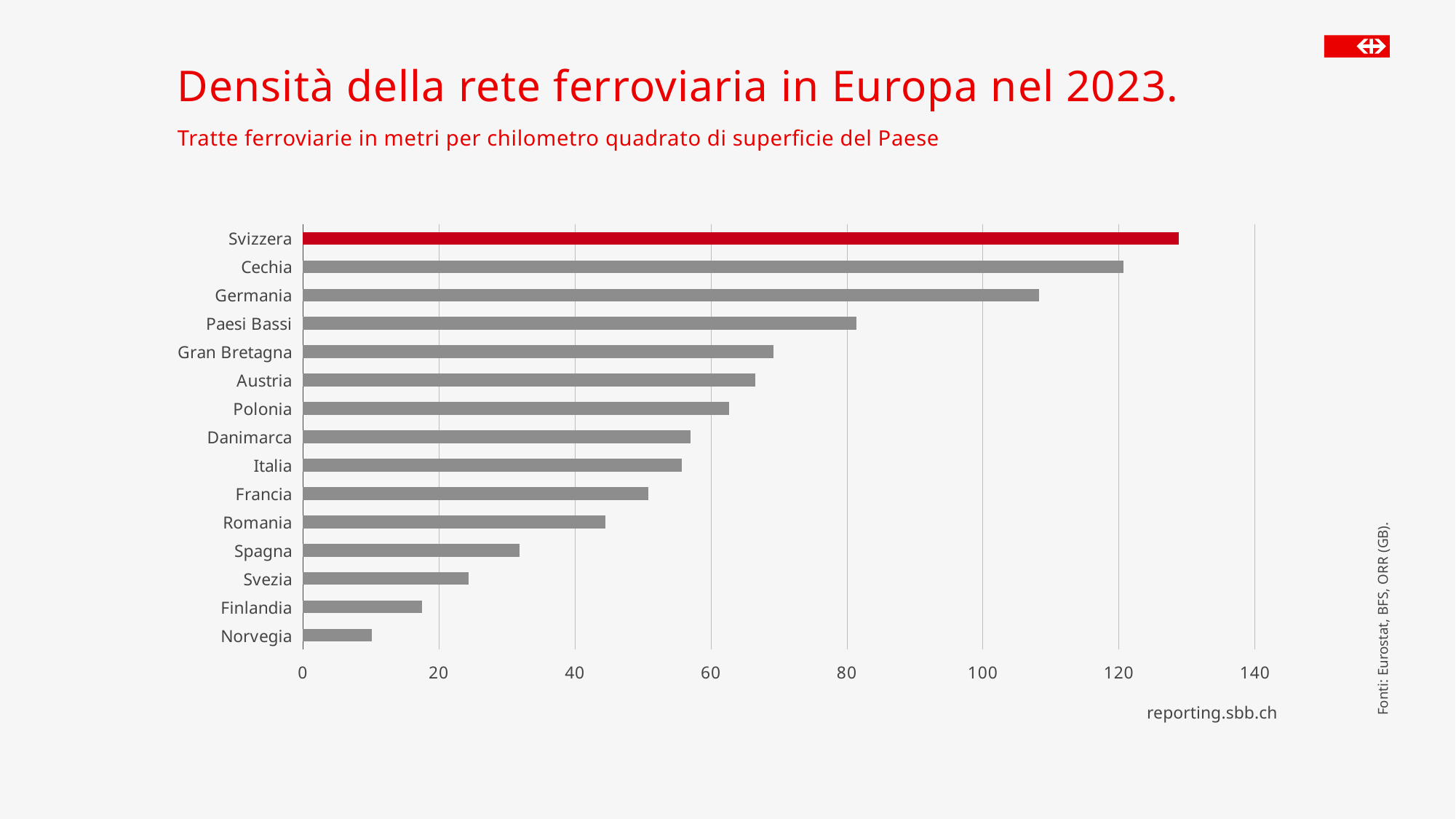
Is the value for Germania greater or less than 100? greater Which has a higher value, Cechia or Germania? Cechia Is the value for Spagna greater or less than 40? less Is the value for Norvegia greater or less than 20? less Which country has the highest rail network density in the chart? Svizzera What kind of chart is shown on the slide? bar chart Which has a higher value, Francia or Romania? Francia Which country has the lowest rail network density in the chart? Norvegia How many countries are shown in the chart? 15 Which bar is highlighted in red in the chart? Svizzera